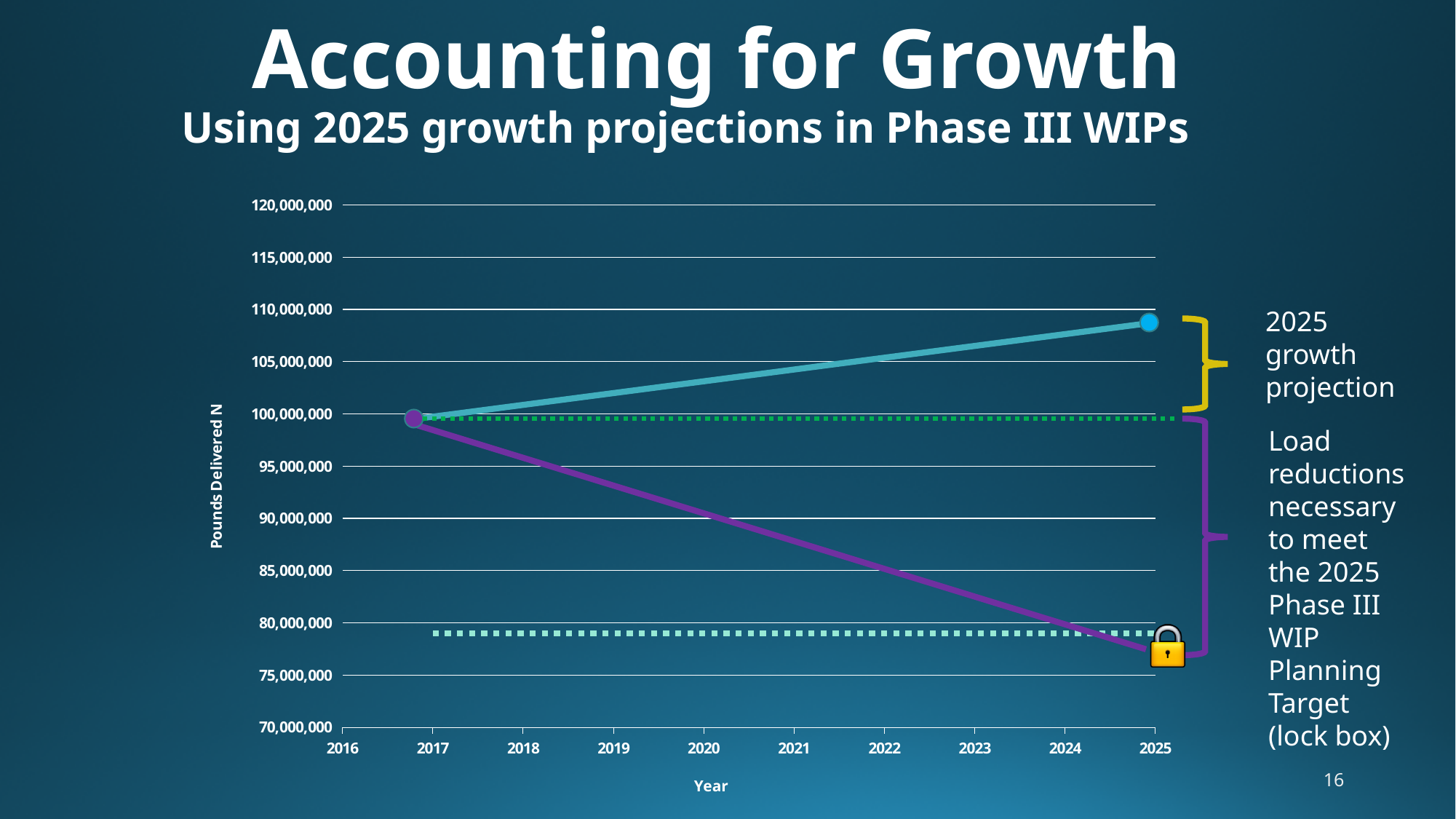
In 2025, which line has the higher value: the blue growth projection line or the purple load reduction line? The blue growth projection line Does the blue line (2025 growth projection) rise or fall from 2017 to 2025? Rises Is the value of the blue growth projection line in 2025 greater or less than 110,000,000? less Does the purple line (load reductions) rise or fall from 2017 to 2025? Falls What is the label of the y axis? Pounds Delivered N What kind of chart is shown on the slide? Line chart What is the label of the x axis? Year Is the value of the purple load reduction line in 2025 greater or less than 80,000,000? less Is the value of the blue growth projection line in 2025 greater or less than 105,000,000? greater How many year labels are shown on the x axis? 10